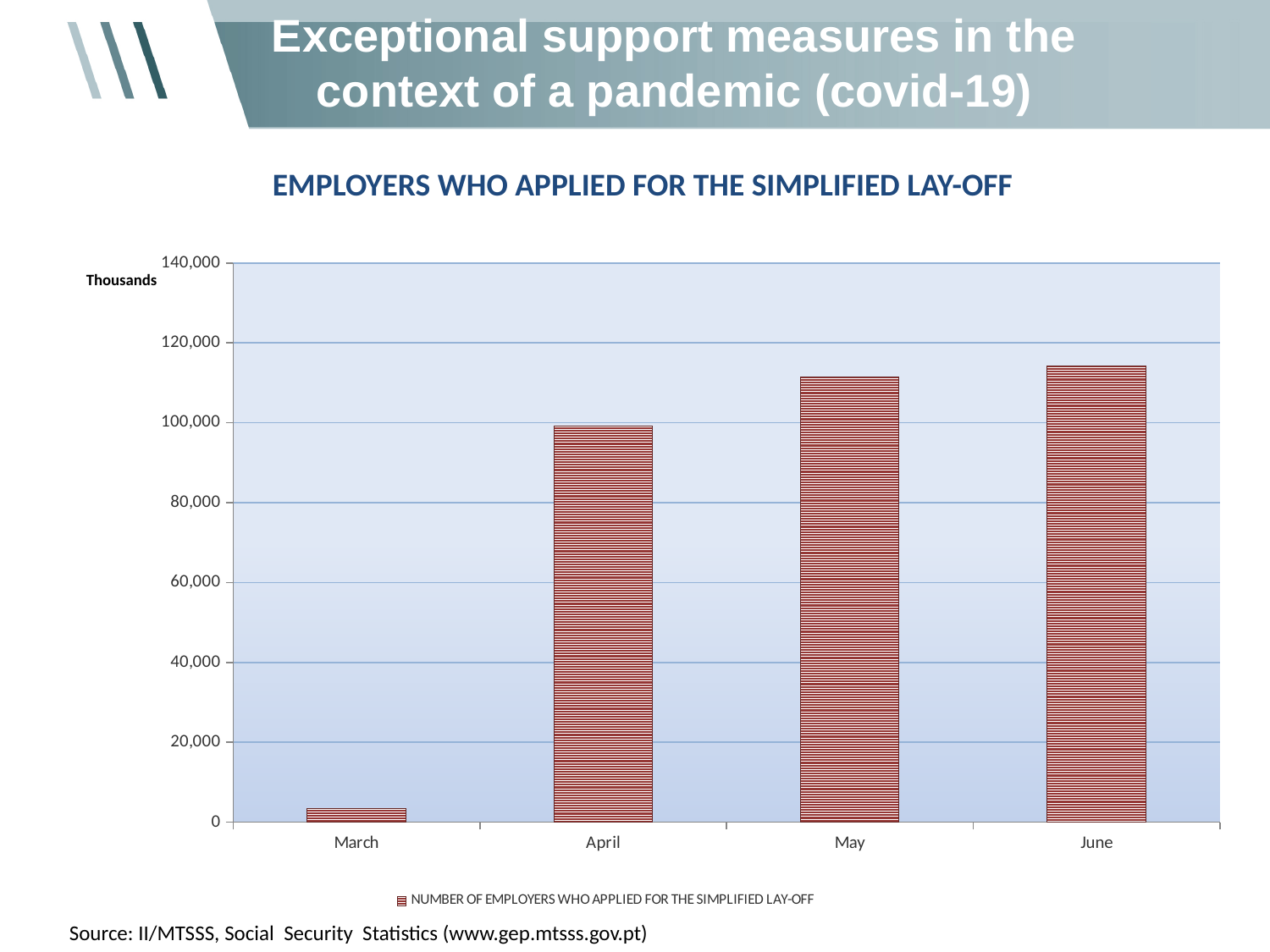
Which is larger, the value for March or the value for April? April Which month has the lowest number of employers who applied for the simplified lay-off? March What is the title of the chart? EMPLOYERS WHO APPLIED FOR THE SIMPLIFIED LAY-OFF How many months are shown on the x axis of the chart? 4 Do the values rise or fall from March to June? rise Is the value for March greater or less than 20,000? less Is the value for April greater or less than 80,000? greater What unit label is shown next to the vertical axis of the chart? Thousands What type of chart is shown on the slide? bar chart Is the value for June greater or less than 120,000? less How many series does the chart legend list? 1